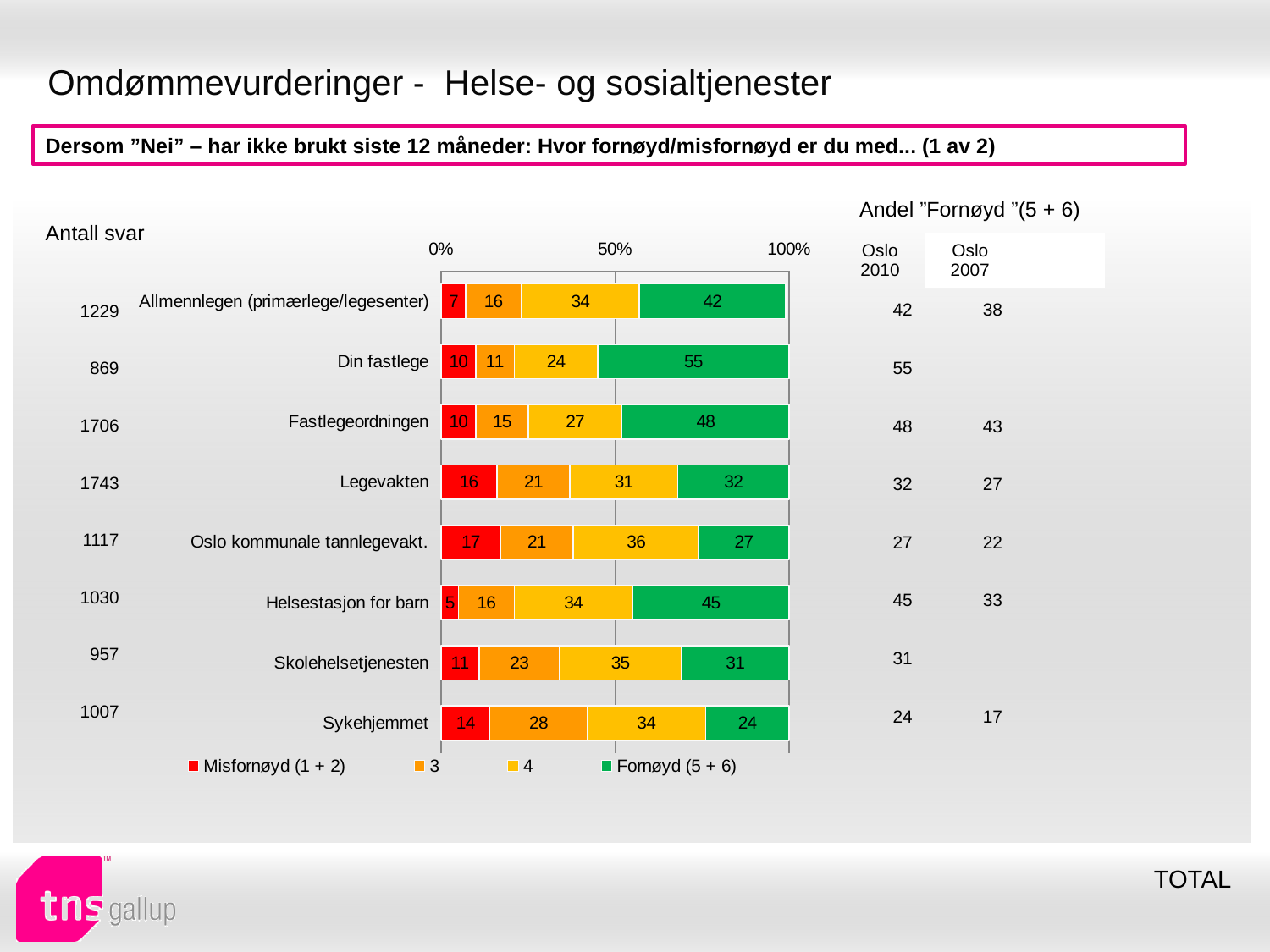
Which category has the lowest Misfornøyd (1 + 2) value? Helsestasjon for barn Which is larger: the Fornøyd (5 + 6) value for Legevakten or for Helsestasjon for barn? Helsestasjon for barn What kind of chart is shown on the slide? Stacked bar chart Which category has the lowest Fornøyd (5 + 6) value? Sykehjemmet What is the Fornøyd (5 + 6) value for Din fastlege? 55 How many categories (services) are plotted in the chart? 8 What is the value of series 4 for Oslo kommunale tannlegevakt.? 36 Which category has the highest Fornøyd (5 + 6) value? Din fastlege What is the total of the stacked bar for Din fastlege? 100 What is the Misfornøyd (1 + 2) value for Sykehjemmet? 14 What is the difference between the Fornøyd (5 + 6) values for Din fastlege and Sykehjemmet? 31 How many series does the chart legend list? 4